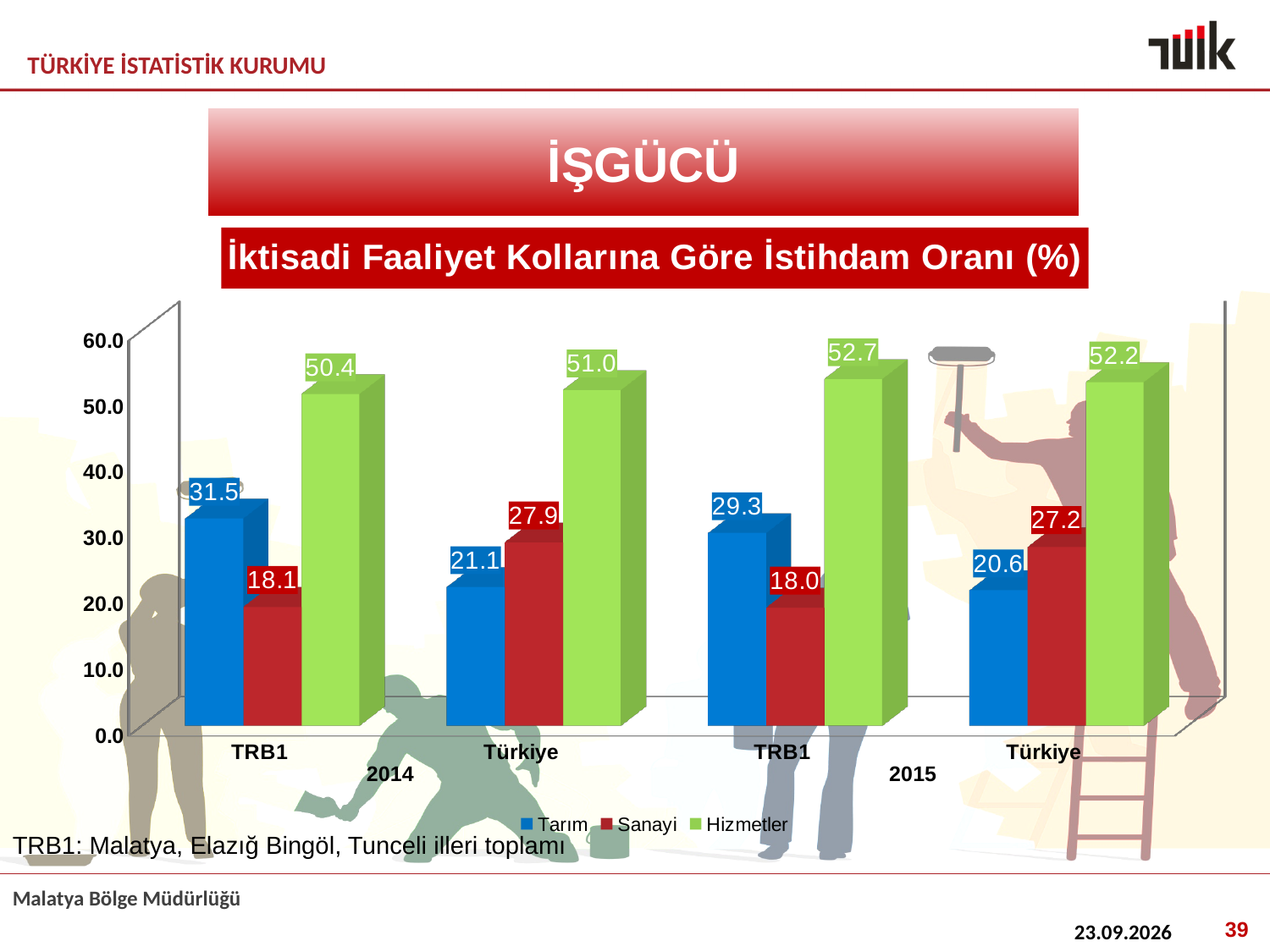
What is the difference between the Sanayi values for Türkiye and TRB1 in 2014? 9.8 Which category has the highest Hizmetler value? TRB1 2015 How many category groups are shown on the x axis? 4 Which category has the lowest Sanayi value? TRB1 2015 What is the Sanayi value for TRB1 in 2015? 18.0 What is the Tarım value for Türkiye in 2014? 21.1 How many series does the legend list? 3 What kind of chart is shown on the slide? Bar chart What is the Tarım value for TRB1 in 2014? 31.5 What is the Hizmetler value for Türkiye in 2015? 52.2 What is the title of the chart? İktisadi Faaliyet Kollarına Göre İstihdam Oranı (%) Which is larger, the Tarım value for TRB1 in 2015 or the Tarım value for Türkiye in 2015? TRB1 in 2015